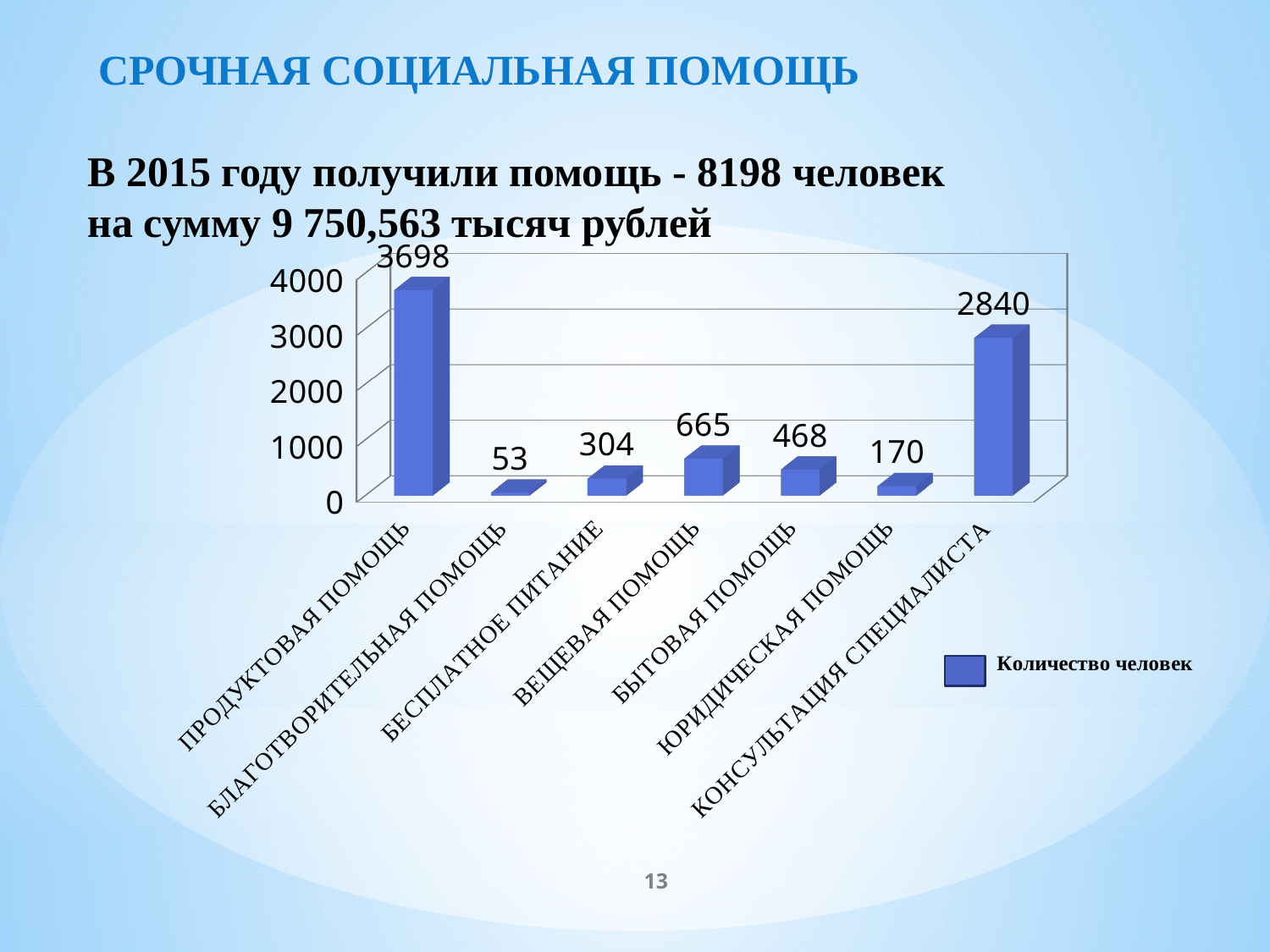
What is the value for КОНСУЛЬТАЦИЯ СПЕЦИАЛИСТА? 2840 What kind of chart is shown on the slide? bar chart What is the value for ВЕЩЕВАЯ ПОМОЩЬ? 665 How many categories are shown on the chart? 7 Is the value for ВЕЩЕВАЯ ПОМОЩЬ greater or less than 1000? less What is the value for ПРОДУКТОВАЯ ПОМОЩЬ? 3698 What is the value for ЮРИДИЧЕСКАЯ ПОМОЩЬ? 170 What is the difference between the values for ПРОДУКТОВАЯ ПОМОЩЬ and КОНСУЛЬТАЦИЯ СПЕЦИАЛИСТА? 858 Which is larger, the value for БЫТОВАЯ ПОМОЩЬ or the value for БЕСПЛАТНОЕ ПИТАНИЕ? БЫТОВАЯ ПОМОЩЬ What series name does the legend show? Количество человек Which category has the highest value? ПРОДУКТОВАЯ ПОМОЩЬ Which category has the lowest value? БЛАГОТВОРИТЕЛЬНАЯ ПОМОЩЬ